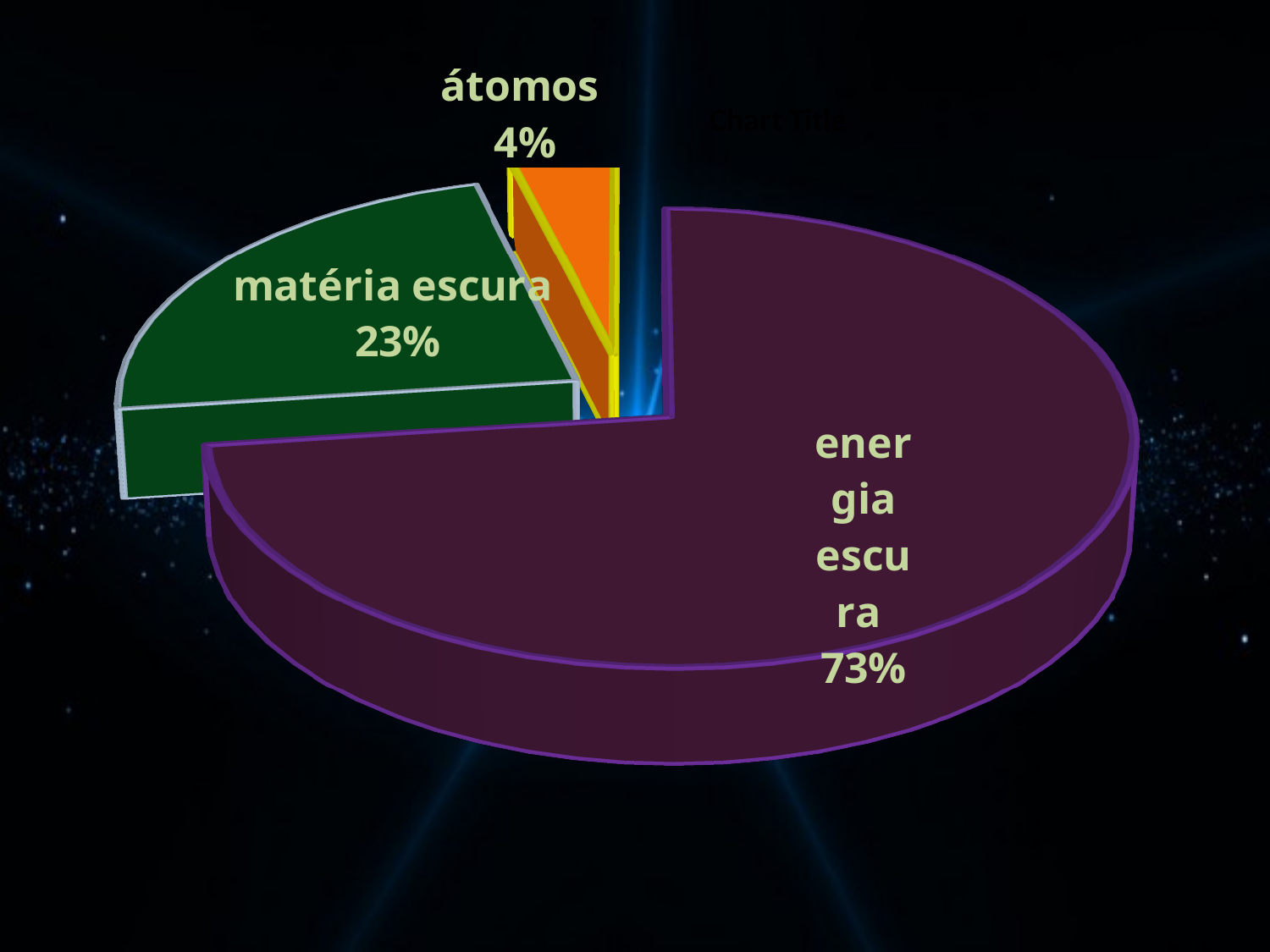
What share of the pie does "energia escura" represent? 73% What share of the pie does "átomos" represent? 4% What is the difference in percentage points between "matéria escura" and "átomos"? 19 What kind of chart is shown on the slide? pie chart Which is larger, the share for "matéria escura" or the share for "átomos"? matéria escura What share of the pie does "matéria escura" represent? 23% What colour is the "matéria escura" slice? green What colour is the "energia escura" slice? purple What is the difference in percentage points between "energia escura" and "matéria escura"? 50 Which slice of the pie is the smallest? átomos How many slices does the pie chart have? 3 Which slice of the pie is the largest? energia escura